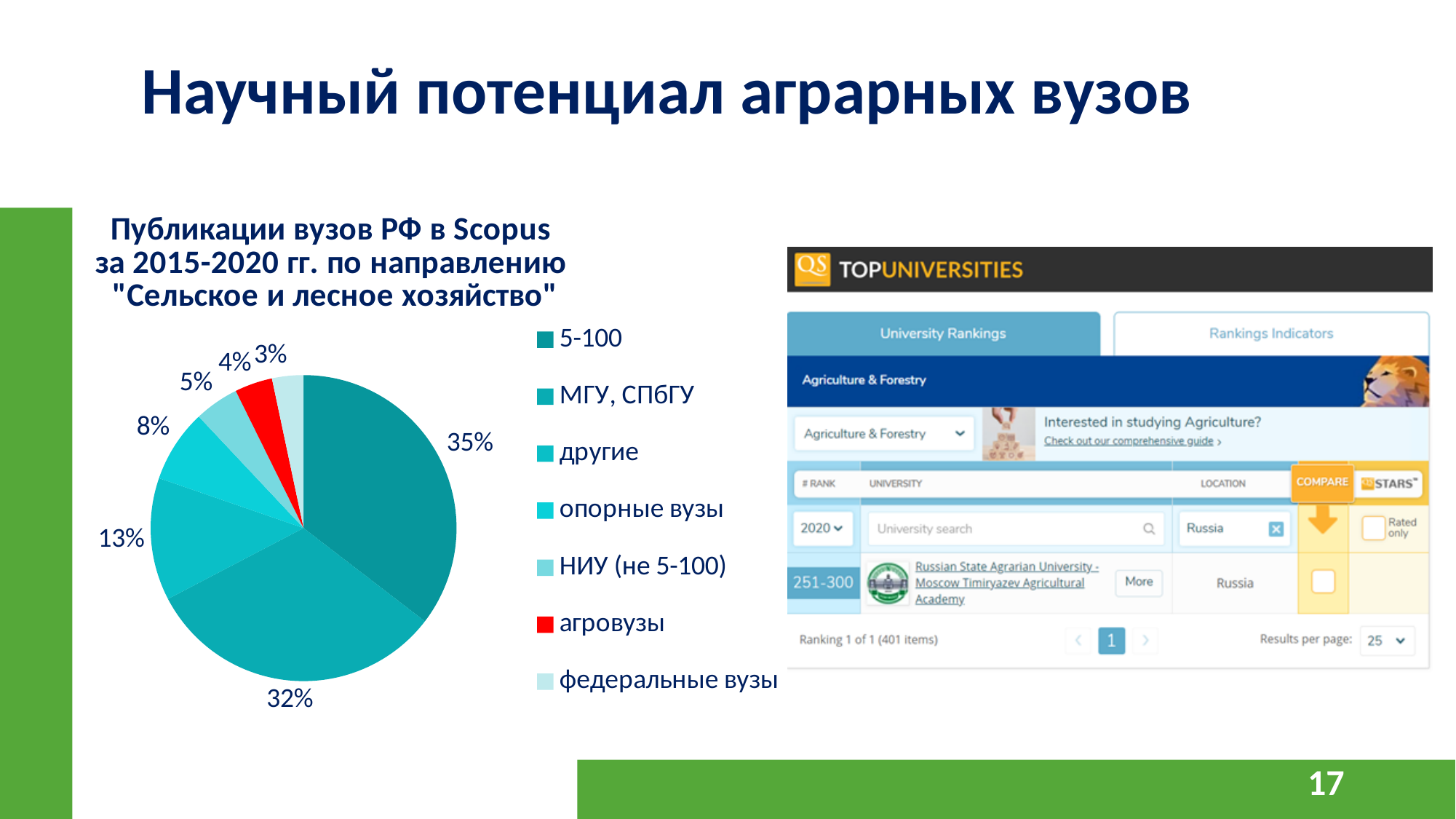
How many categories does the legend of the pie chart list? 7 Which category has the smallest share of the pie? федеральные вузы Which category is shown in red on the pie chart? агровузы What type of chart is shown on the slide? pie chart What share of publications does the "агровузы" category account for? 4% What is the difference in percentage points between the "другие" share and the "НИУ (не 5-100)" share? 8 Which is larger: the share for "другие" or the share for "опорные вузы"? другие What share of publications does the "МГУ, СПбГУ" category account for? 32% Which category has the largest share of the pie? 5-100 What share of publications does the "федеральные вузы" category account for? 3%